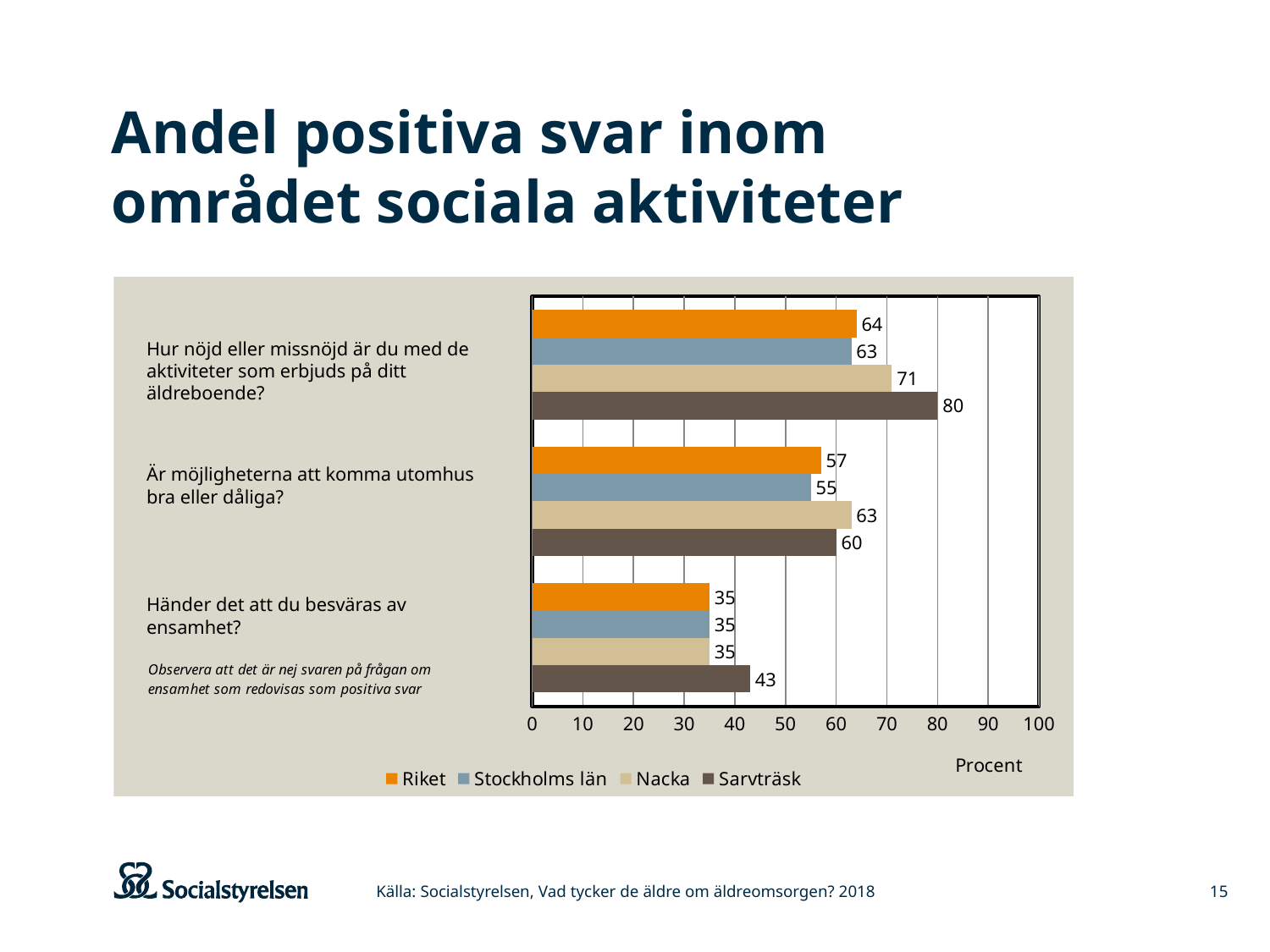
What is the value for Sarvträsk on the question "Hur nöjd eller missnöjd är du med de aktiviteter som erbjuds på ditt äldreboende?"? 80 What unit is shown on the horizontal axis of the chart? Procent Which series has the lowest value on the question "Är möjligheterna att komma utomhus bra eller dåliga?"? Stockholms län How many questions (categories) are shown on the chart? 3 What kind of chart is shown on the slide? Bar chart Which is larger on the question "Är möjligheterna att komma utomhus bra eller dåliga?": Nacka or Sarvträsk? Nacka What is the value for Riket on the question "Händer det att du besväras av ensamhet?"? 35 What is the value for Nacka on the question "Är möjligheterna att komma utomhus bra eller dåliga?"? 63 Which series has the highest value on the question "Hur nöjd eller missnöjd är du med de aktiviteter som erbjuds på ditt äldreboende?"? Sarvträsk How many series does the legend list? 4 What is the difference between Sarvträsk and Nacka on the question "Händer det att du besväras av ensamhet?"? 8 What is the difference between Sarvträsk and Riket on the question "Hur nöjd eller missnöjd är du med de aktiviteter som erbjuds på ditt äldreboende?"? 16